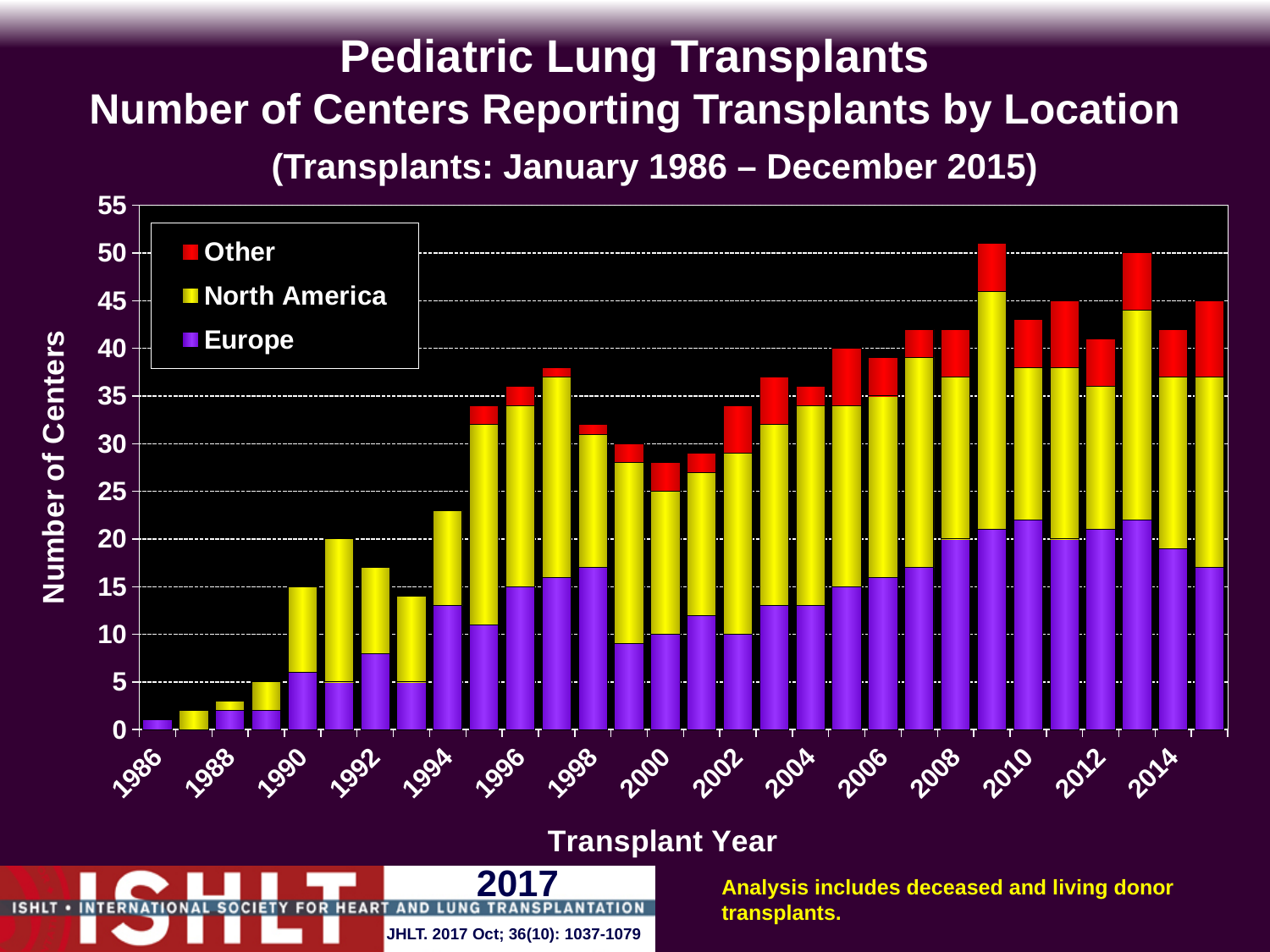
Is the number of Europe centers for 1994 greater or less than 10? greater Does the total number of centers rise or fall from 1986 to 1990? rise Which year has a larger total number of centers, 1994 or 1995? 1995 Is the total number of centers for 1990 greater or less than 10? greater Which year has a larger total number of centers, 1991 or 1992? 1991 Is the total number of centers for 1986 greater or less than 5? less Which series is shown in red in the legend? Other How many series does the legend list? 3 What is the label of the vertical axis? Number of Centers What kind of chart is shown on the slide? Stacked bar chart Which transplant year has the lowest total number of centers? 1986